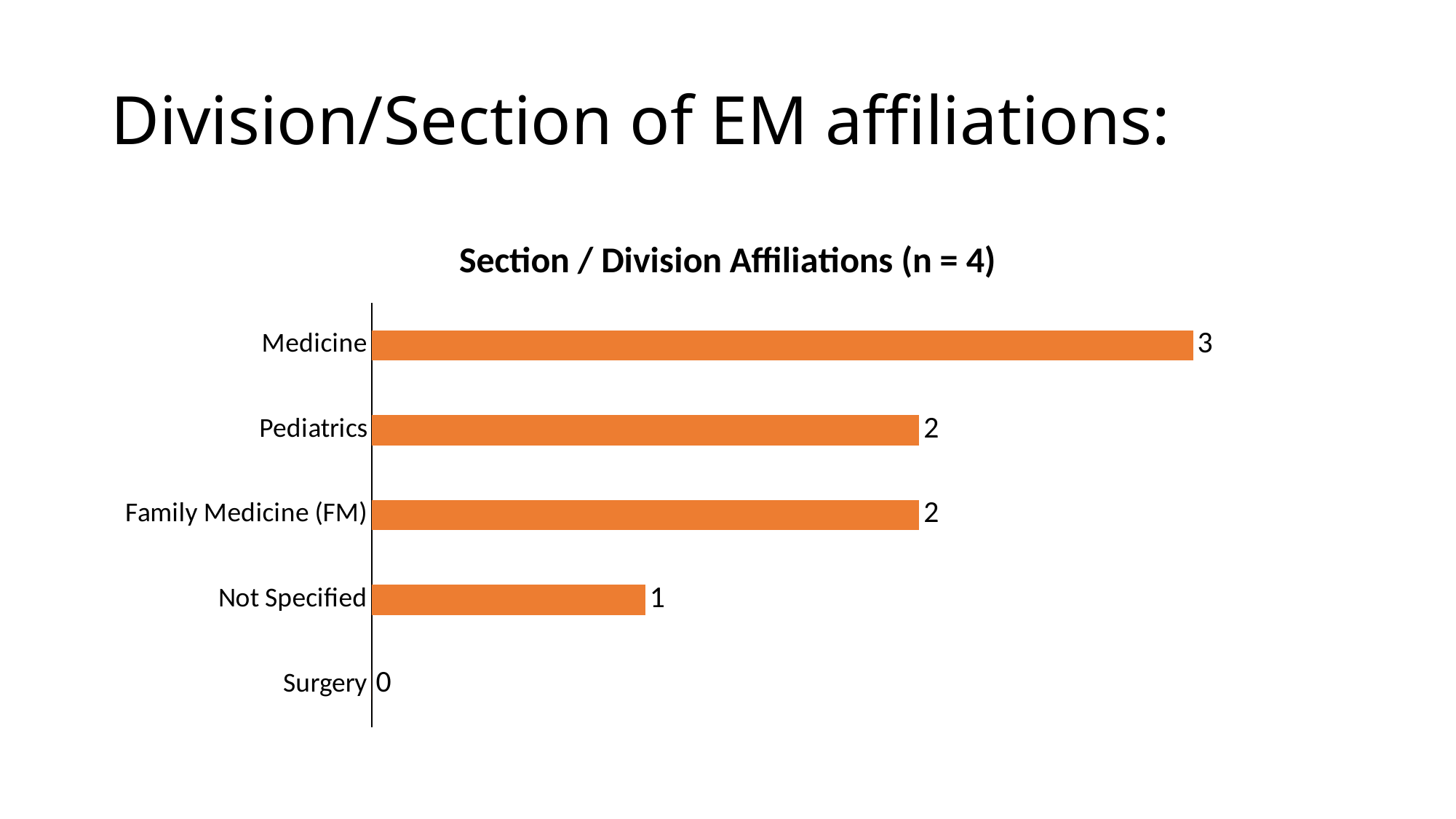
Which category has the lowest value? Surgery What is the title of the chart? Section / Division Affiliations (n = 4) Which category has the highest value? Medicine How many categories are shown in the chart? 5 What kind of chart is shown on the slide? Bar chart What is the value for Not Specified? 1 What is the value for Medicine? 3 What is the difference between the values for Medicine and Not Specified? 2 What is the value for Surgery? 0 Which is larger, the value for Family Medicine (FM) or the value for Not Specified? Family Medicine (FM) What colour are the bars in the chart? Orange What is the value for Pediatrics? 2